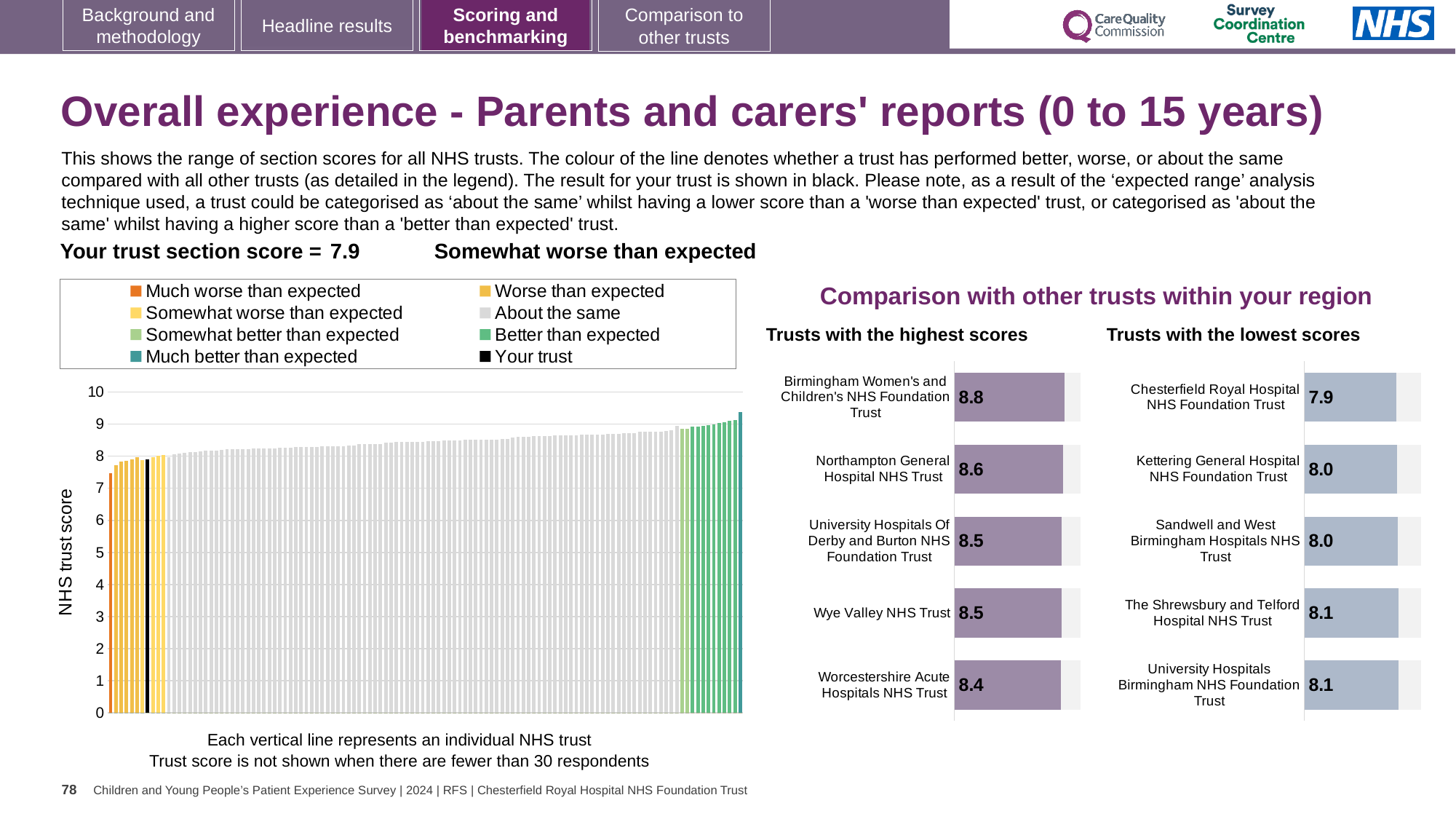
In the 'Trusts with the highest scores' chart, what is the score for Birmingham Women's and Children's NHS Foundation Trust? 8.8 In the 'Trusts with the lowest scores' chart, which has the higher score: Kettering General Hospital NHS Foundation Trust or Chesterfield Royal Hospital NHS Foundation Trust? Kettering General Hospital NHS Foundation Trust In the 'Trusts with the highest scores' chart, which trust has the highest score? Birmingham Women's and Children's NHS Foundation Trust How many entries does the legend of the main NHS trust score chart list? 8 In the 'Trusts with the lowest scores' chart, what is the difference between the scores of The Shrewsbury and Telford Hospital NHS Trust and Chesterfield Royal Hospital NHS Foundation Trust? 0.2 In the main NHS trust score chart, is the value of the highest bar greater or less than 9? greater In the 'Trusts with the lowest scores' chart, what is the score for Kettering General Hospital NHS Foundation Trust? 8.0 In the 'Trusts with the lowest scores' chart, which trust has the lowest score? Chesterfield Royal Hospital NHS Foundation Trust What kind of chart is the main NHS trust score chart on the left? Bar chart In the 'Trusts with the highest scores' chart, what is the score for Worcestershire Acute Hospitals NHS Trust? 8.4 In the 'Trusts with the highest scores' chart, what is the difference between the scores of Birmingham Women's and Children's NHS Foundation Trust and Worcestershire Acute Hospitals NHS Trust? 0.4 How many trusts are listed in the 'Trusts with the highest scores' chart? 5